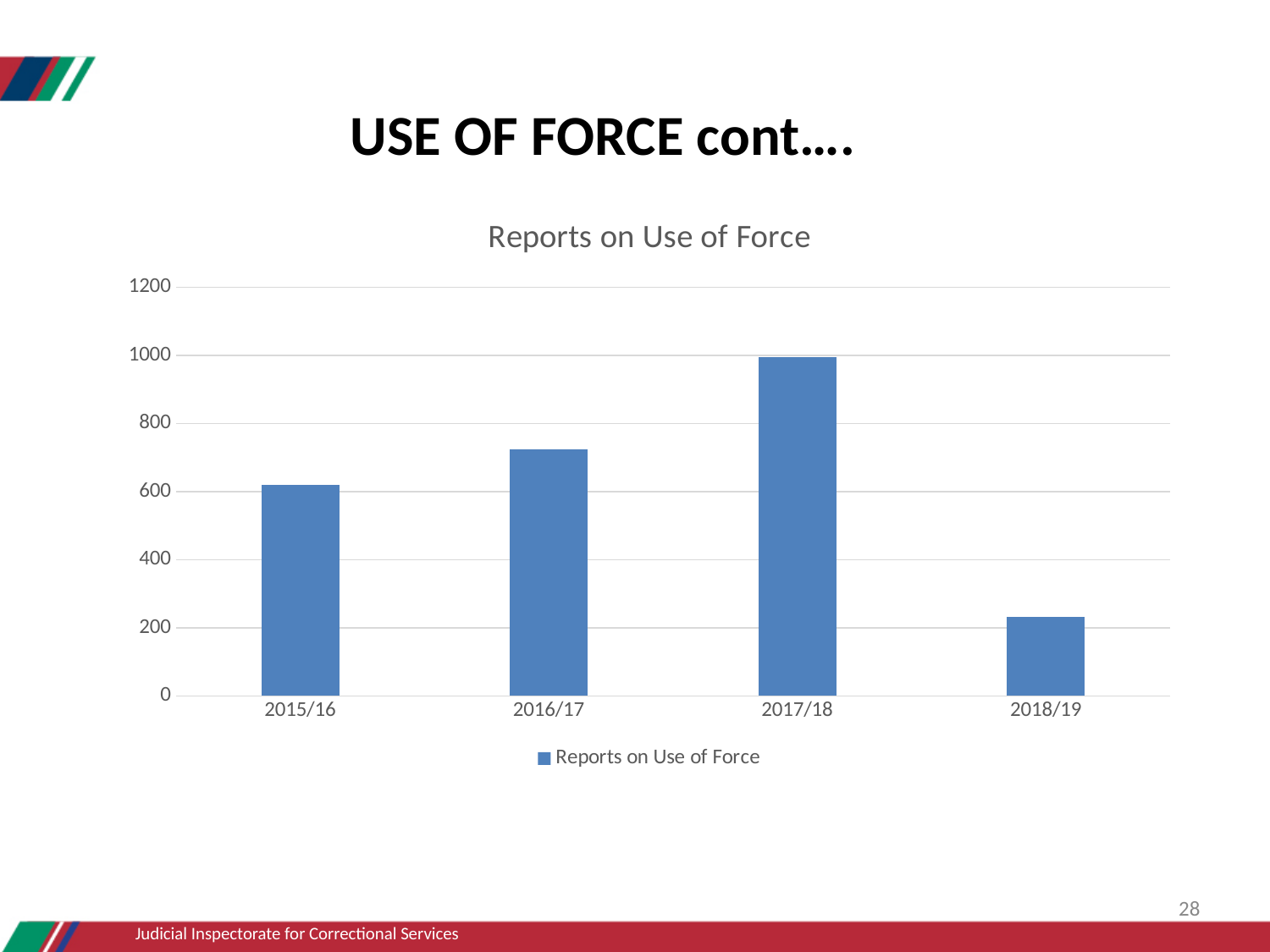
Is the value for 2018/19 greater or less than 400? less Which is larger, the value for 2016/17 or the value for 2015/16? 2016/17 What type of chart is shown on the slide? bar chart How many series does the legend list? 1 What is the title of the chart? Reports on Use of Force How many categories (years) are shown on the x axis? 4 Do the values rise or fall from 2015/16 to 2017/18? rise Is the value for 2015/16 greater or less than 400? greater Which year has the lowest number of reports on use of force? 2018/19 Which year has the highest number of reports on use of force? 2017/18 Is the value for 2016/17 greater or less than 800? less